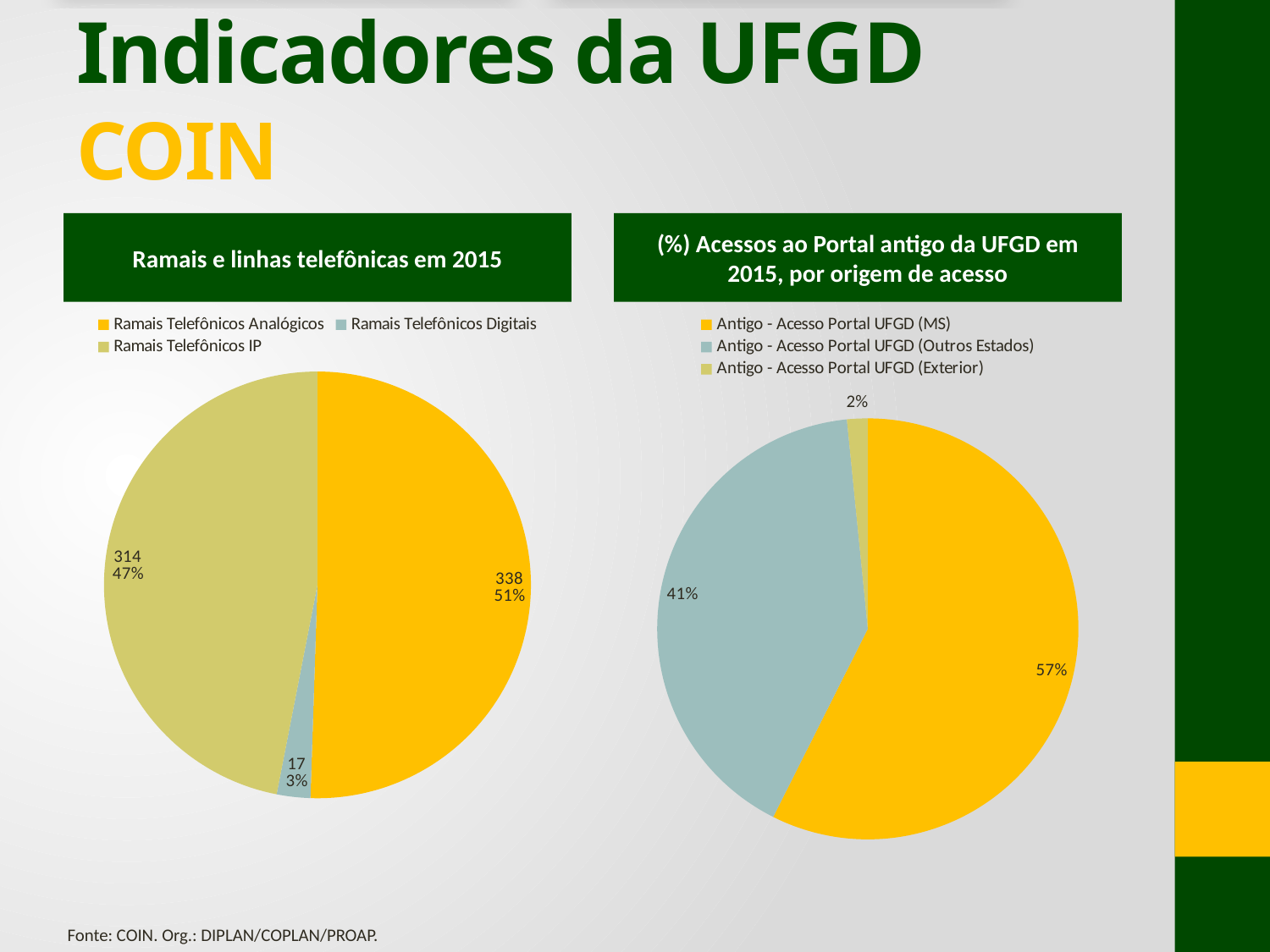
In the '(%) Acessos ao Portal antigo da UFGD em 2015, por origem de acesso' chart, which origin has the smallest share? Antigo - Acesso Portal UFGD (Exterior) In the 'Ramais e linhas telefônicas em 2015' chart, how many Ramais Telefônicos IP are there? 314 In the '(%) Acessos ao Portal antigo da UFGD em 2015, por origem de acesso' chart, what percentage of accesses came from Outros Estados? 41% In the '(%) Acessos ao Portal antigo da UFGD em 2015, por origem de acesso' chart, how many categories does the legend list? 3 In the 'Ramais e linhas telefônicas em 2015' chart, how many Ramais Telefônicos Analógicos are there? 338 In the '(%) Acessos ao Portal antigo da UFGD em 2015, por origem de acesso' chart, what percentage of accesses came from MS? 57% In the '(%) Acessos ao Portal antigo da UFGD em 2015, por origem de acesso' chart, which is larger: the share for MS or the share for Outros Estados? MS In the 'Ramais e linhas telefônicas em 2015' chart, what is the total number of ramais across all three categories? 669 What kind of chart is 'Ramais e linhas telefônicas em 2015'? Pie chart In the 'Ramais e linhas telefônicas em 2015' chart, what share of the pie do Ramais Telefônicos Digitais represent? 3% In the 'Ramais e linhas telefônicas em 2015' chart, what is the difference between Ramais Telefônicos Analógicos and Ramais Telefônicos IP? 24 In the 'Ramais e linhas telefônicas em 2015' chart, which category has the smallest value? Ramais Telefônicos Digitais